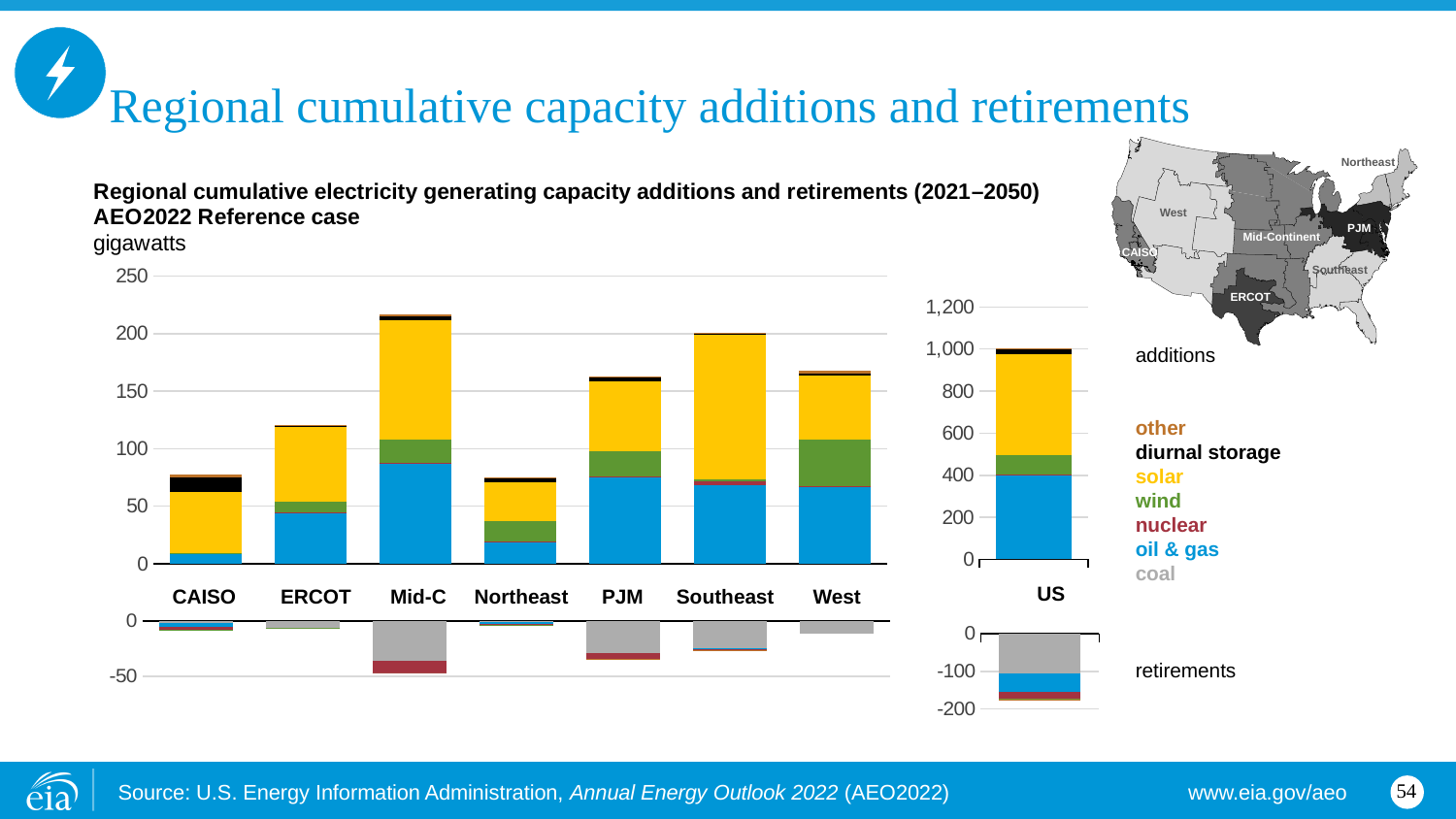
In the regional retirements chart (left, bottom), which region has the largest cumulative retirements? Mid-C In the regional additions chart (left, top), which is larger, the total for Southeast or the total for PJM? Southeast What kind of chart is used to show the regional cumulative capacity additions? Stacked bar chart In the regional additions chart (left, top), is the value for ERCOT greater or less than 100? greater In the US additions chart (right, top), is the value for US greater or less than 800? greater What unit is given for the values in the capacity charts? gigawatts In the regional additions chart (left, top), which is larger, the total for West or the total for ERCOT? West How many regions are shown on the x axis of the regional additions chart (left, top)? 7 In the regional additions chart (left, top), is the value for Northeast greater or less than 100? less In the regional additions chart (left, top), which region has the highest cumulative capacity additions? Mid-C How many series does the legend list for the capacity charts? 7